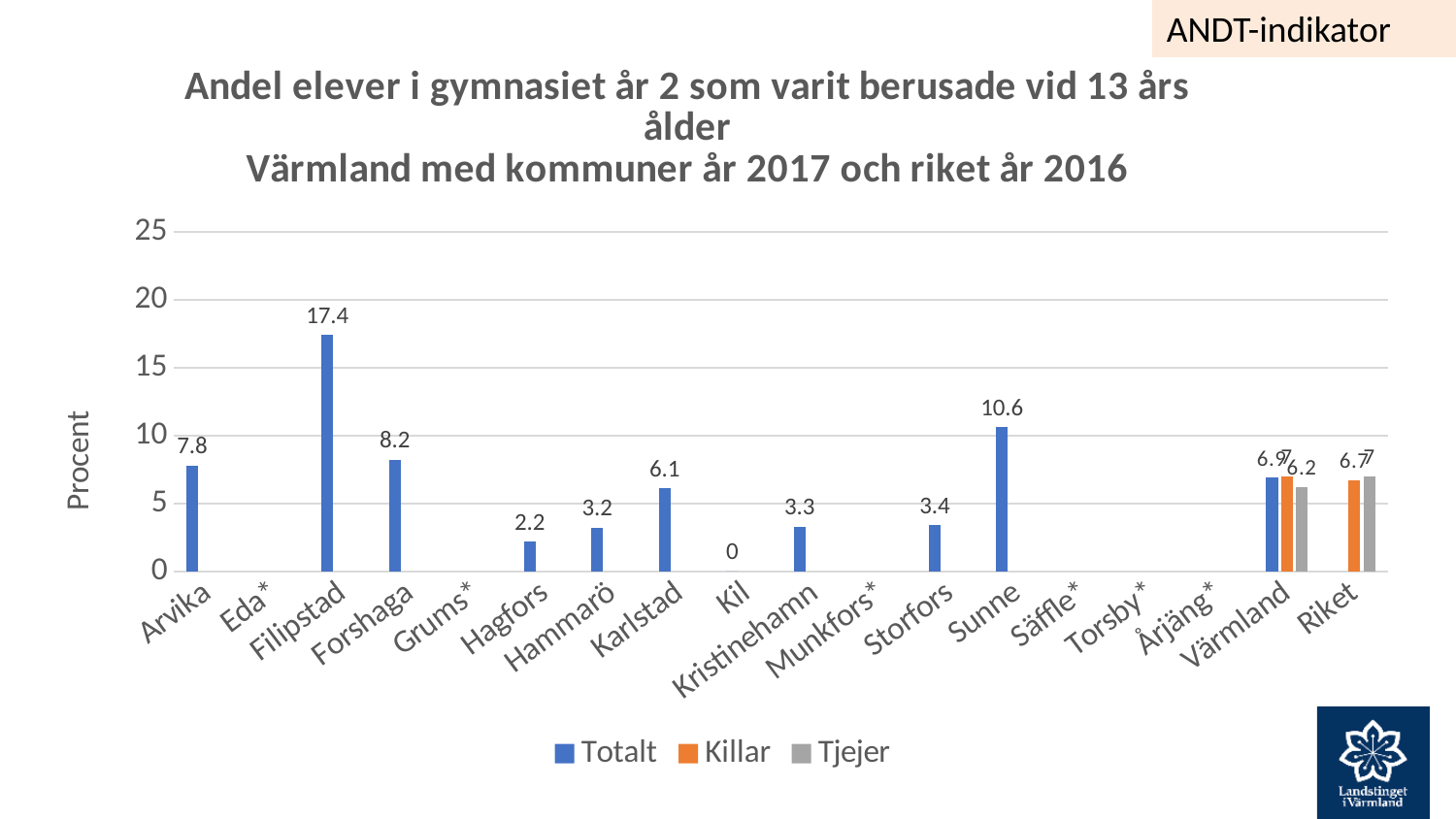
What is the Totalt value for Sunne? 10.6 What is the difference between the Totalt values for Filipstad and Sunne? 6.8 What is the Tjejer value for Värmland? 6.2 Is the Totalt value for Filipstad greater or less than 15? greater What kind of chart is shown on the slide? Bar chart Which municipality has the highest Totalt value? Filipstad Which has a higher Totalt value, Arvika or Forshaga? Forshaga What is the Totalt value for Kil? 0 How many series does the legend list? 3 How many categories are shown on the x axis? 18 What is the Totalt value for Filipstad? 17.4 What is the label on the y axis? Procent